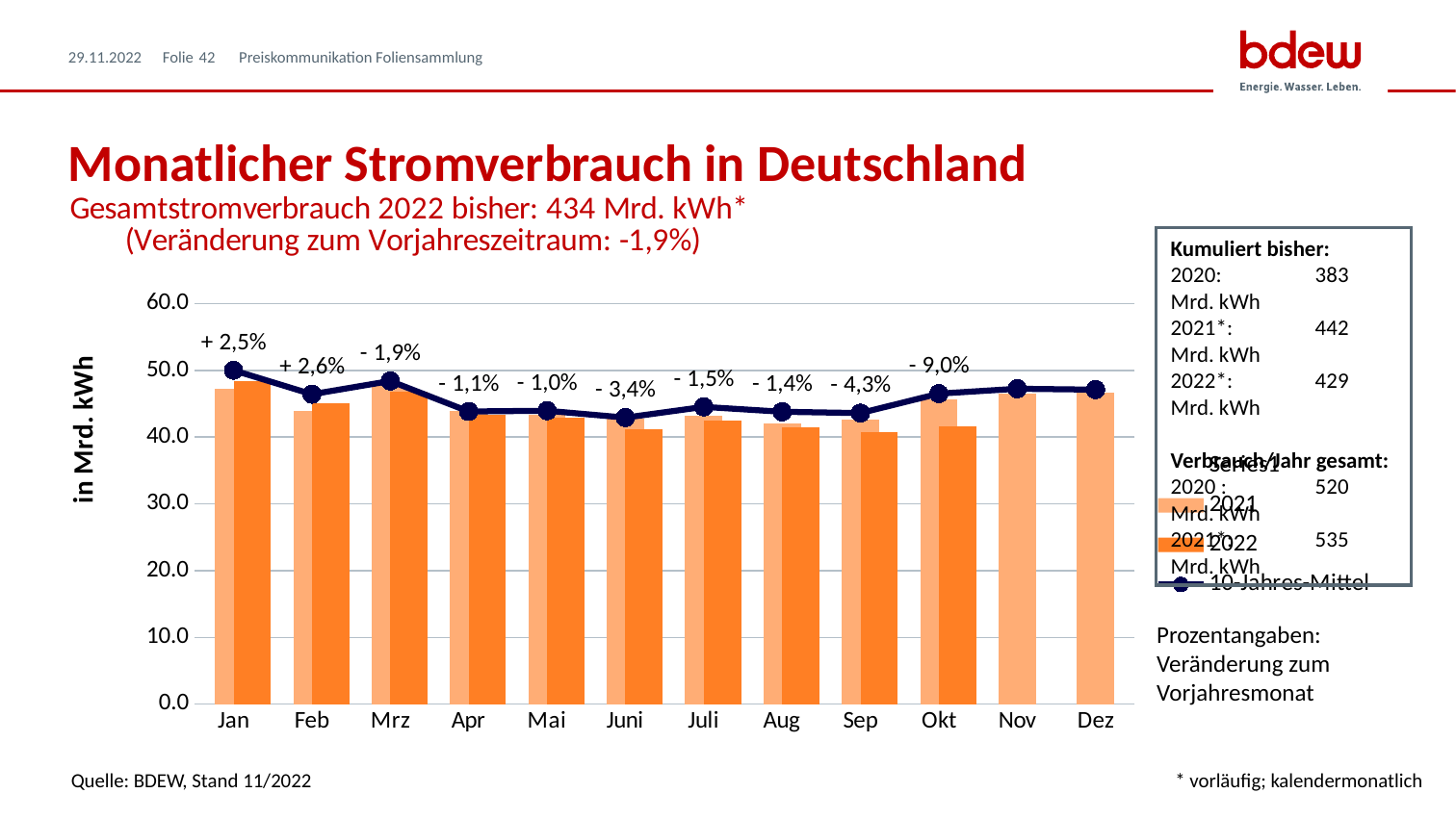
What is the percentage change shown for Jan? + 2,5% What is the percentage change shown for Juni? - 3,4% What is the label of the y axis? in Mrd. kWh Which month shows the highest percentage change? Feb What is the difference in percentage points between the changes shown for Okt and Sep? 4,7 percentage points What is the percentage change shown for Okt? - 9,0% Is the 2022 value for Okt greater or less than 50? less Is the 2022 value for Jan greater or less than 40? greater Which month shows the largest negative percentage change? Okt What is the percentage change shown for Sep? - 4,3% Which is larger for Okt, the 2021 value or the 2022 value? 2021 How many months are shown on the x axis? 12